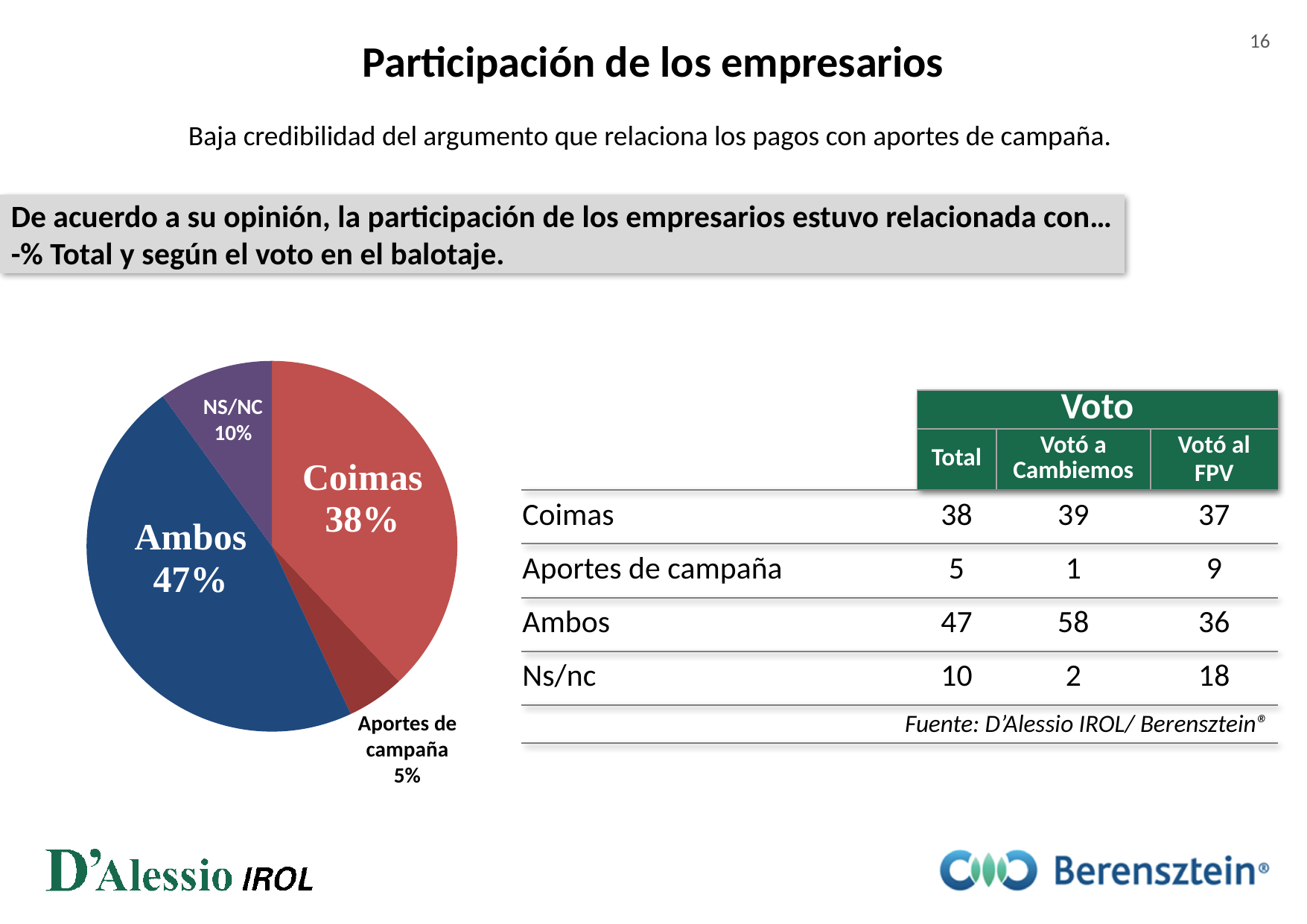
What is the value for Aportes de campaña in the pie chart? 5% What is the value for Ambos in the pie chart? 47% What share of the pie does the Coimas slice represent? 38% Which slice of the pie chart is the largest? Ambos What kind of chart is shown on the slide? Pie chart What is the value for NS/NC in the pie chart? 10% Which is larger in the pie chart, NS/NC or Aportes de campaña? NS/NC Which slice of the pie chart is the smallest? Aportes de campaña How many slices does the pie chart have? 4 What is the difference between the Ambos and Coimas slices in the pie chart? 9% What colour is the Ambos slice in the pie chart? Blue What is the value for Coimas in the pie chart? 38%